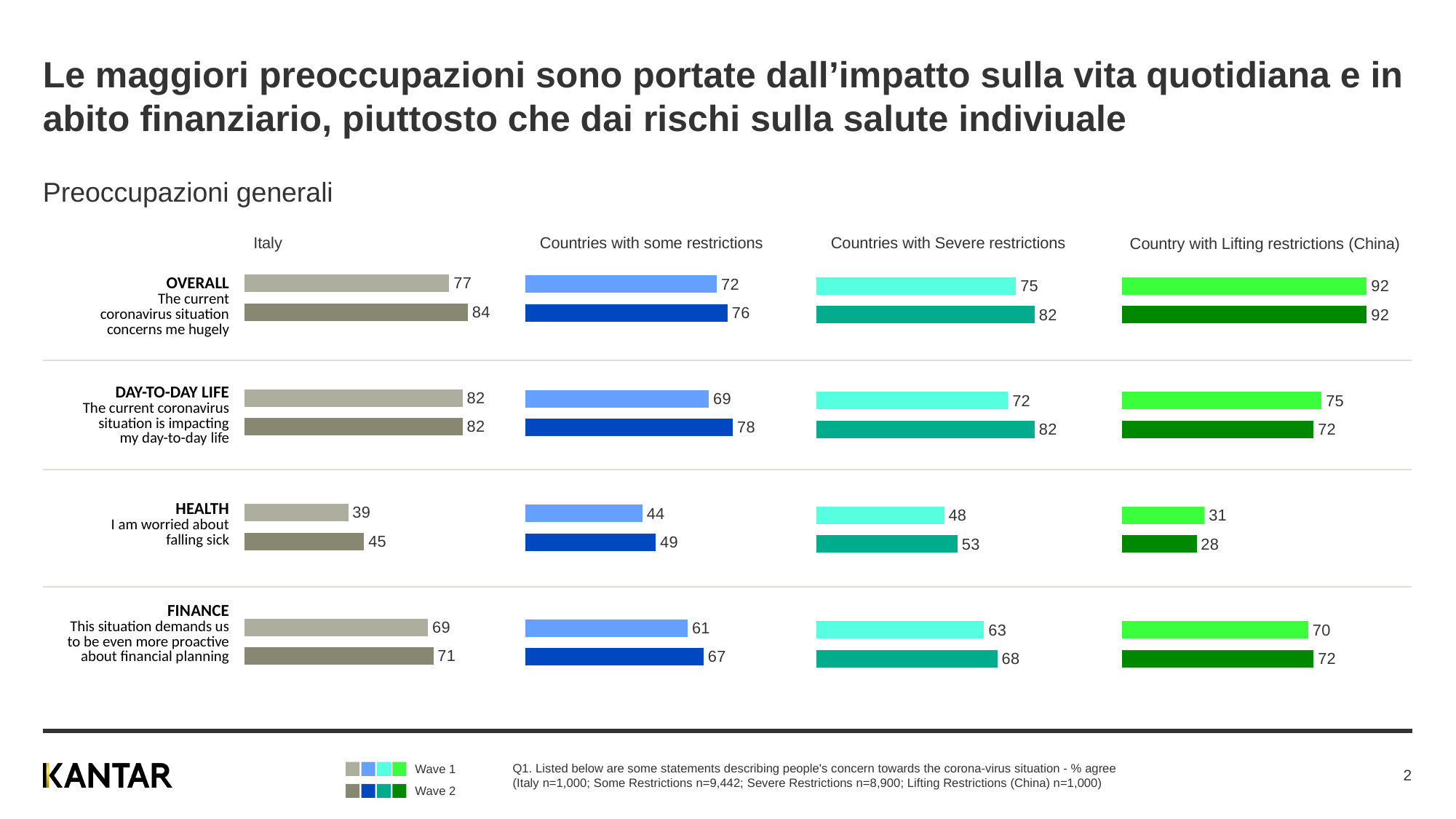
In the Countries with some restrictions chart, which category has the lowest Wave 1 value? HEALTH What type of chart is used on this slide? Bar chart In the Countries with Severe restrictions chart, what is the Wave 2 value for FINANCE? 68 How many categories (statements) are shown in each chart? 4 In the Italy chart, what is the difference between the Wave 2 and Wave 1 values for OVERALL? 7 In the Countries with Severe restrictions chart, is the Wave 1 value for HEALTH larger or smaller than the Wave 2 value for HEALTH? smaller In the Italy chart, what is the Wave 2 value for OVERALL? 84 In the Country with Lifting restrictions (China) chart, is the Wave 1 value for DAY-TO-DAY LIFE larger or smaller than the Wave 2 value? larger In the Country with Lifting restrictions (China) chart, which category has the highest Wave 2 value? OVERALL In the Countries with some restrictions chart, what is the difference between the Wave 2 and Wave 1 values for DAY-TO-DAY LIFE? 9 How many series (waves) does the legend list? 2 In the Country with Lifting restrictions (China) chart, what is the Wave 1 value for HEALTH? 31